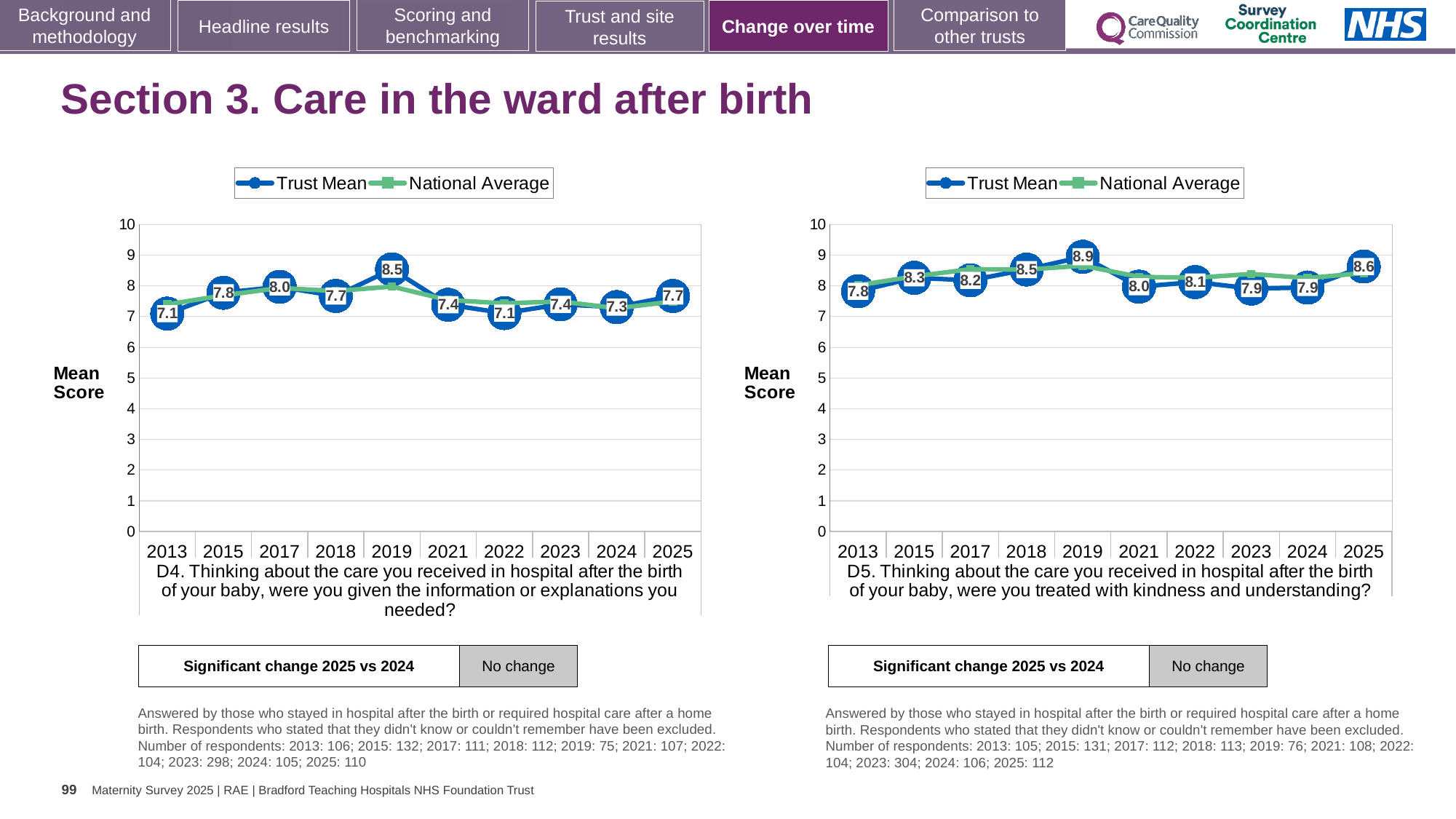
In the left chart (D4), which year has the highest Trust Mean score? 2019 In the left chart (D4), what is the difference between the Trust Mean scores for 2025 and 2024? 0.4 In the left chart (D4), what is the Trust Mean score for 2019? 8.5 What type of chart is the left chart (D4)? Line chart How many years are shown on the x axis of the left chart (D4)? 10 In the right chart (D5), which year has the lowest Trust Mean score? 2013 In the right chart (D5), what is the difference between the Trust Mean scores for 2019 and 2021? 0.9 How many series does the legend of the right chart (D5) list? 2 In the left chart (D4), is the Trust Mean value for 2013 greater or less than 8? less In the right chart (D5), is the Trust Mean score higher in 2018 or in 2022? 2018 In the right chart (D5), what is the Trust Mean score for 2025? 8.6 In the right chart (D5), does the Trust Mean rise or fall from 2024 to 2025? Rise